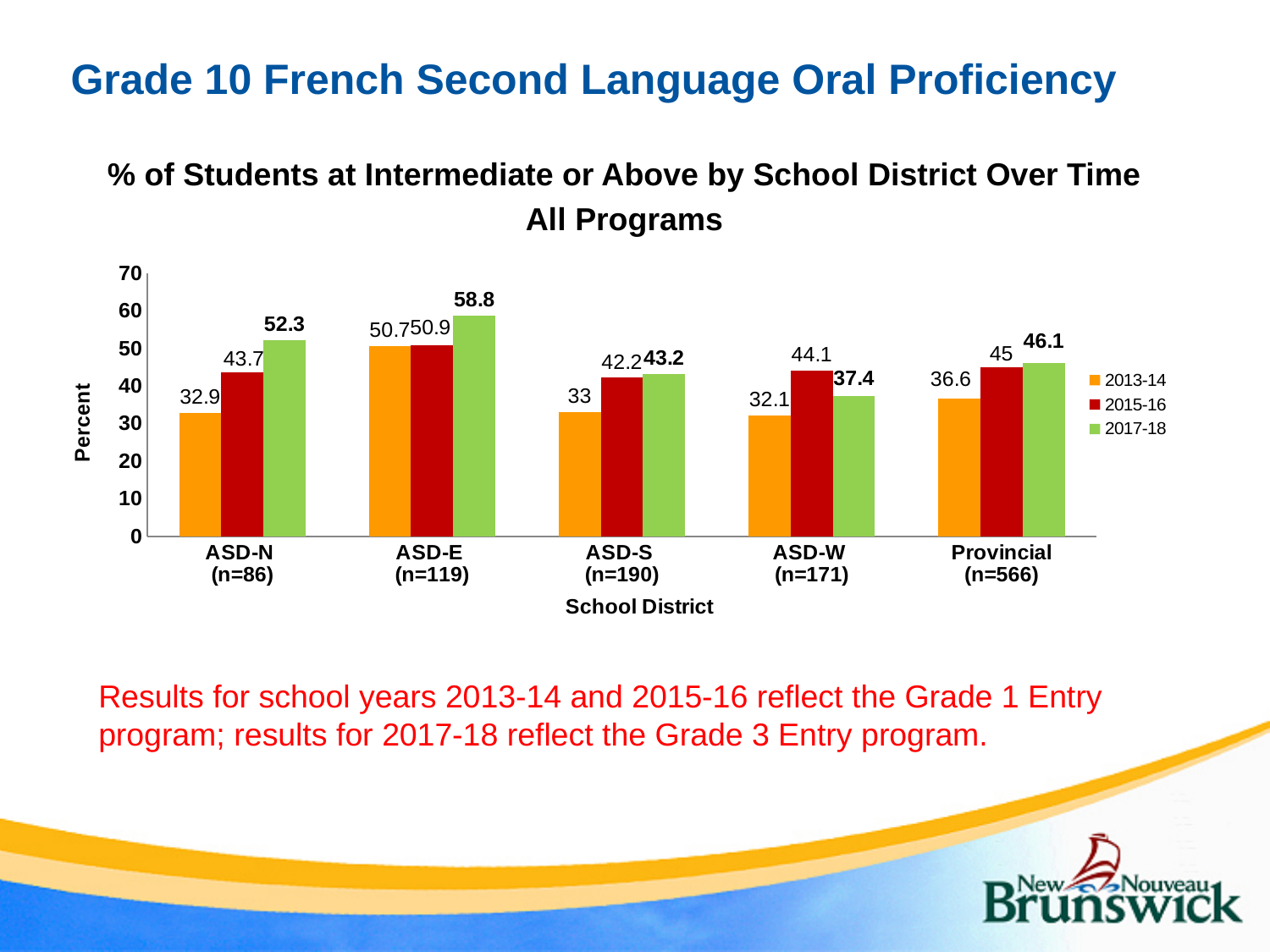
Which is larger for ASD-W: the 2015-16 value or the 2017-18 value? 2015-16 What kind of chart is shown? Bar chart How many school district categories are shown on the x axis? 5 Which colour represents the 2015-16 series in the legend? Red What is the 2017-18 value for ASD-E? 58.8 What is the 2015-16 value for Provincial? 45 What is the difference between the 2017-18 and 2013-14 values for ASD-N? 19.4 How many series does the legend list? 3 Which school district has the highest 2017-18 value? ASD-E What is the 2013-14 value for ASD-W? 32.1 What is the label of the y axis? Percent Which school district has the lowest 2013-14 value? ASD-W